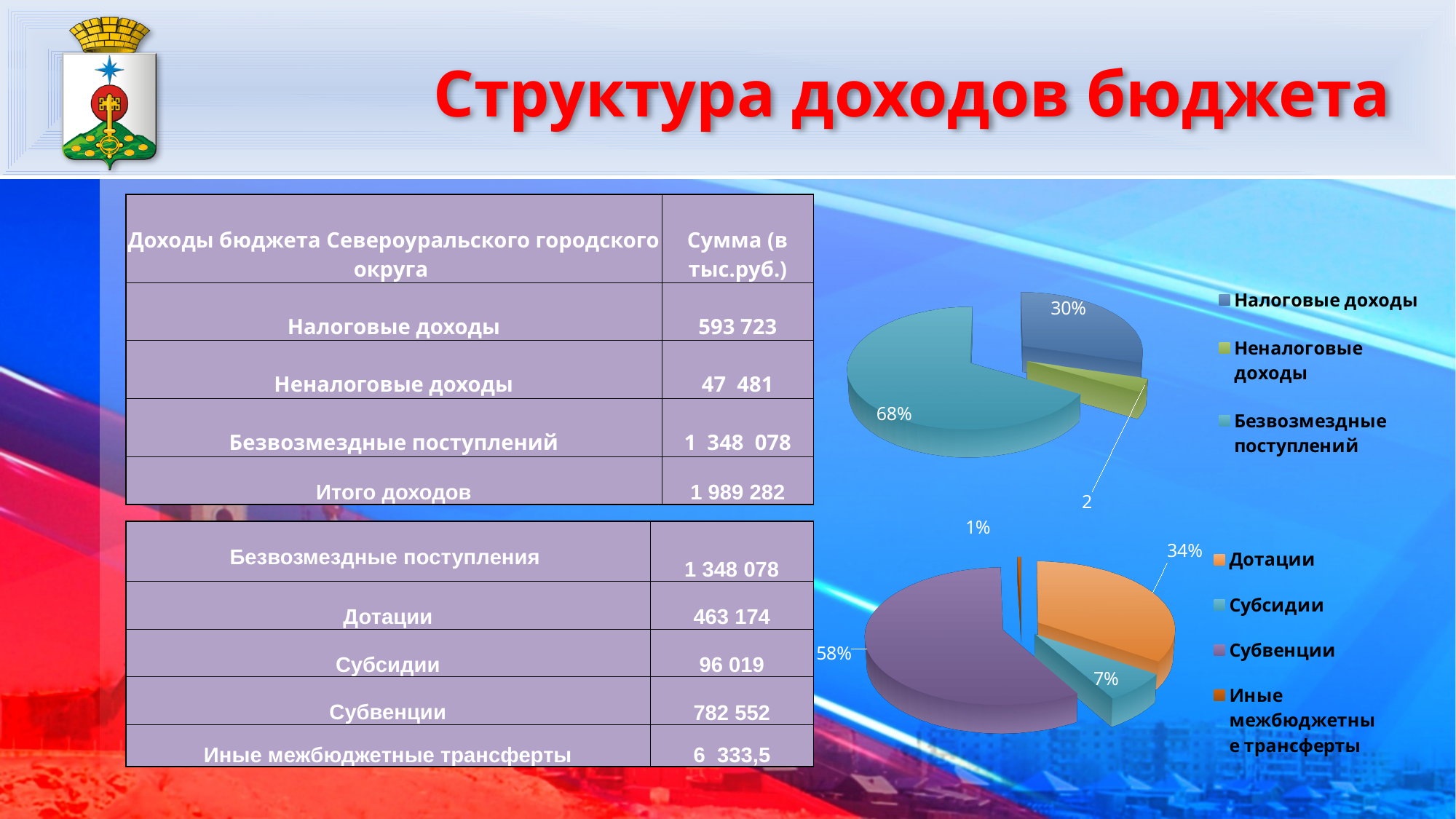
In the top pie chart, which category has the largest slice? Безвозмездные поступлений What type of chart is used on the slide to show the budget income structure? Pie chart In the bottom pie chart, what share is shown for Субвенции? 58% In the bottom pie chart, what share is shown for Дотации? 34% In the top pie chart, what share is shown for Налоговые доходы? 30% In the bottom pie chart, which category has the largest slice? Субвенции In the top pie chart, what share is shown for Безвозмездные поступлений? 68% In the bottom pie chart, what share is shown for Субсидии? 7% In the bottom pie chart, what share is shown for Иные межбюджетные трансферты? 1% In the top pie chart, which category has the smallest slice? Неналоговые доходы How many categories does the legend of the top pie chart list? 3 In the bottom pie chart, what is the difference in percentage points between Субвенции and Дотации? 24